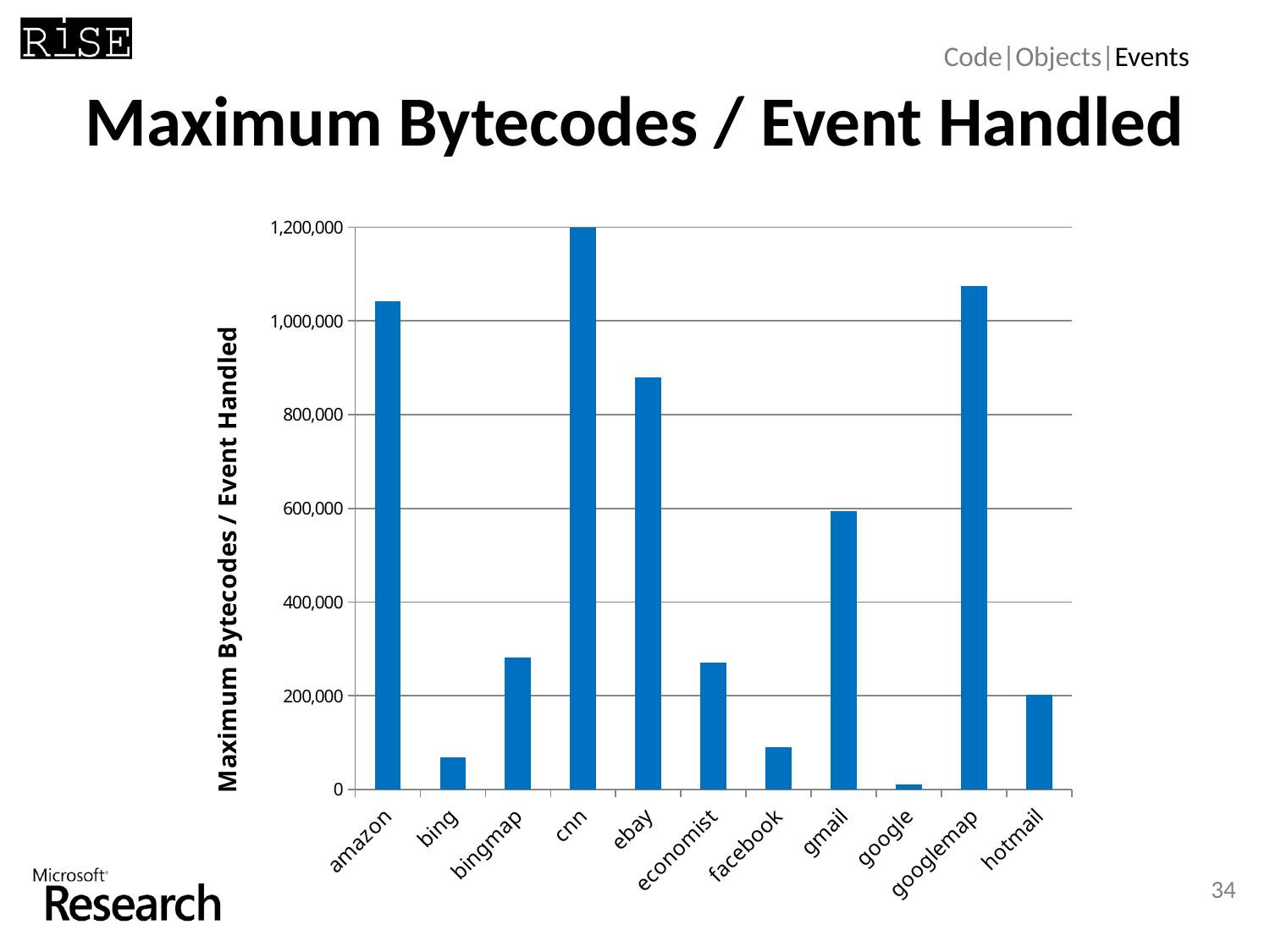
Which website has the highest maximum bytecodes per event handled? cnn Which website has the lowest maximum bytecodes per event handled? google What is the title of the slide containing the chart? Maximum Bytecodes / Event Handled Which has a larger value, amazon or ebay? amazon How many websites (categories) are plotted on the x axis? 11 Is the value for bingmap greater or less than 200,000? greater Which has a larger value, googlemap or gmail? googlemap Is the value for facebook greater or less than 200,000? less What is the label on the vertical axis of the chart? Maximum Bytecodes / Event Handled Is the value for amazon greater or less than 1,000,000? greater What kind of chart is shown on the slide? bar chart